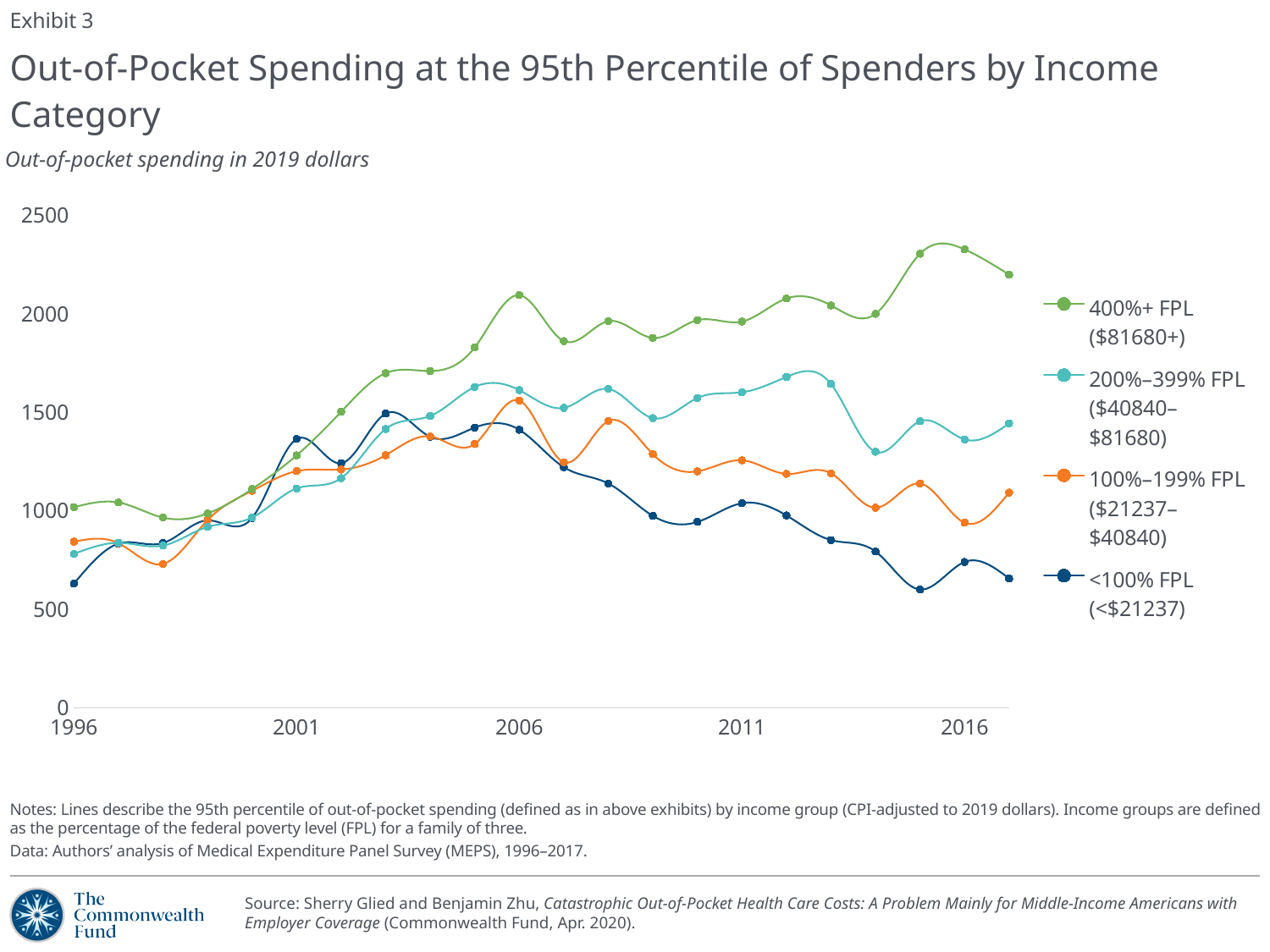
Does the <100% FPL line rise or fall between 2011 and 2016? fall Which income group has the highest out-of-pocket spending in 2016? 400%+ FPL How many series does the legend list? 4 In 2006, which is larger: the value for 400%+ FPL or the value for 100%–199% FPL? 400%+ FPL Is the value for <100% FPL in 2016 greater or less than 1000? less Which income group is shown by the green line? 400%+ FPL ($81680+) Is the value for 200%–399% FPL in 2006 greater or less than 1500? greater Is the value for 400%+ FPL in 2016 greater or less than 2000? greater Which income group has the lowest out-of-pocket spending in 2016? <100% FPL What kind of chart is shown on the slide? line chart What is the title of the chart? Out-of-Pocket Spending at the 95th Percentile of Spenders by Income Category